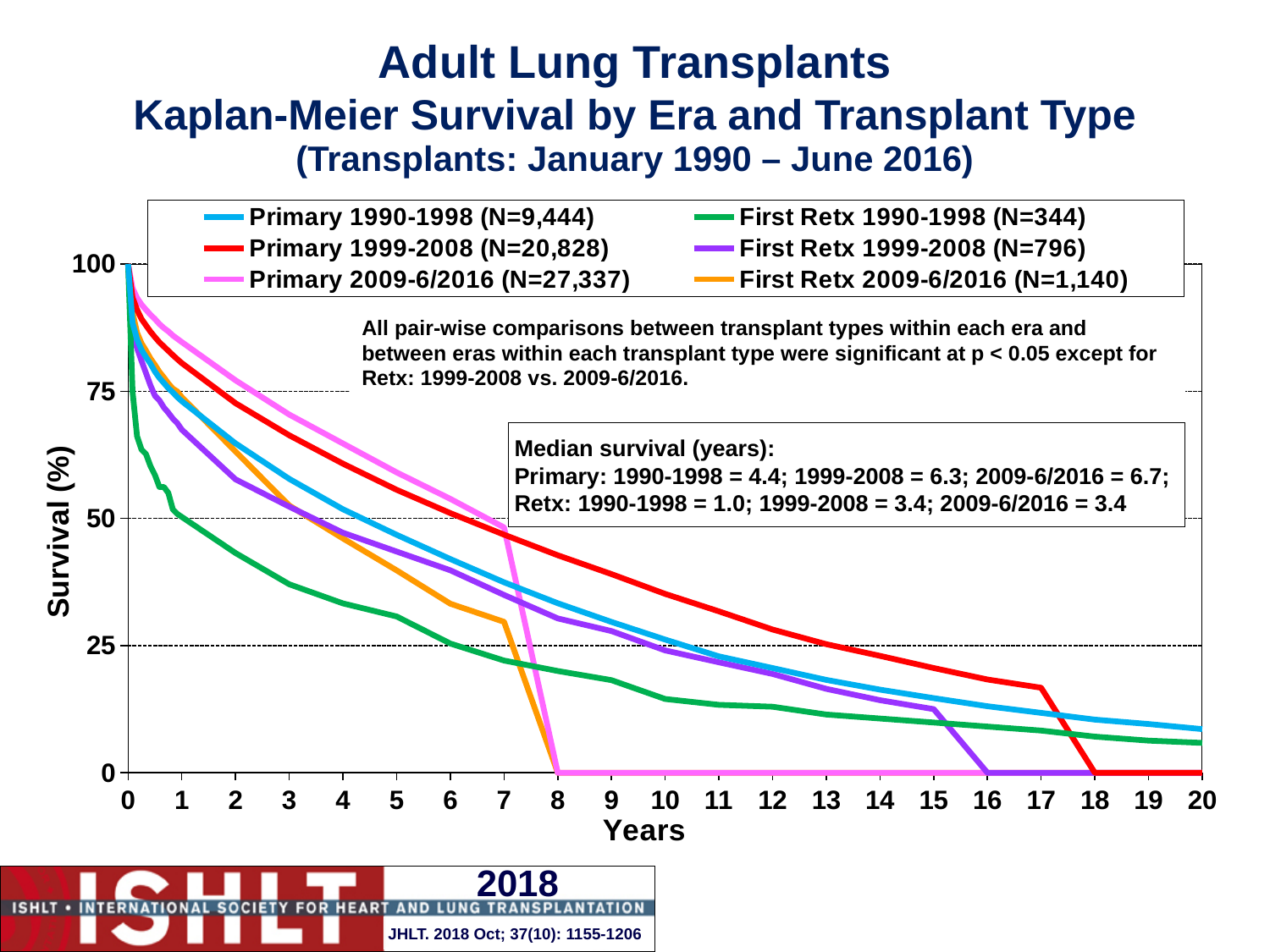
What is the label of the y axis? Survival (%) How many series does the legend list? 6 Which series has the highest survival at 5 years? Primary 2009-6/2016 Is the survival for Primary 2009-6/2016 at 5 years greater or less than 50? greater Which series has the lowest survival at 5 years? First Retx 1990-1998 Is the survival for Primary 1990-1998 at 15 years greater or less than 25? less What kind of chart is shown on the slide? line chart Do the survival curves rise or fall as years increase along the x axis? fall At 3 years, which is higher: survival for Primary 1999-2008 or for First Retx 1990-1998? Primary 1999-2008 What is the median survival in years for Primary 1999-2008 transplants, as stated on the slide? 6.3 Is the survival for Primary 1999-2008 at 10 years greater or less than 25? greater What is the N for the First Retx 2009-6/2016 series in the legend? 1,140